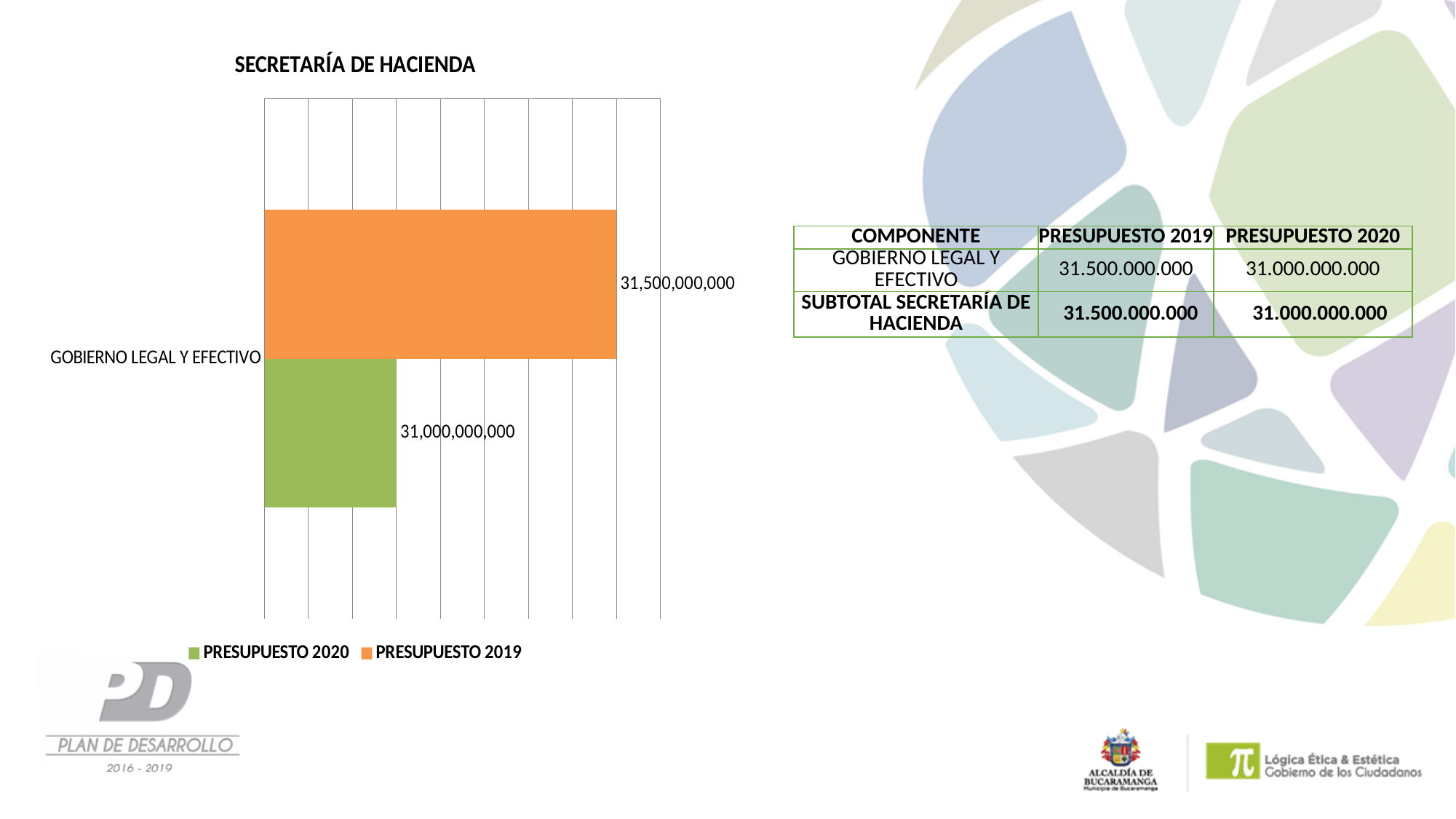
How many categories are shown on the chart? 1 How many series does the chart legend list? 2 Which colour represents PRESUPUESTO 2020 in the chart? Green What is the value of PRESUPUESTO 2020 for GOBIERNO LEGAL Y EFECTIVO in the chart? 31,000,000,000 What kind of chart is shown on the slide? Bar chart What is the name of the single category shown on the chart? GOBIERNO LEGAL Y EFECTIVO What is the value of PRESUPUESTO 2019 for GOBIERNO LEGAL Y EFECTIVO in the chart? 31,500,000,000 Which series has the larger value for GOBIERNO LEGAL Y EFECTIVO, PRESUPUESTO 2019 or PRESUPUESTO 2020? PRESUPUESTO 2019 What is the title of the chart? SECRETARÍA DE HACIENDA What is the difference between the PRESUPUESTO 2019 and PRESUPUESTO 2020 values for GOBIERNO LEGAL Y EFECTIVO? 500,000,000